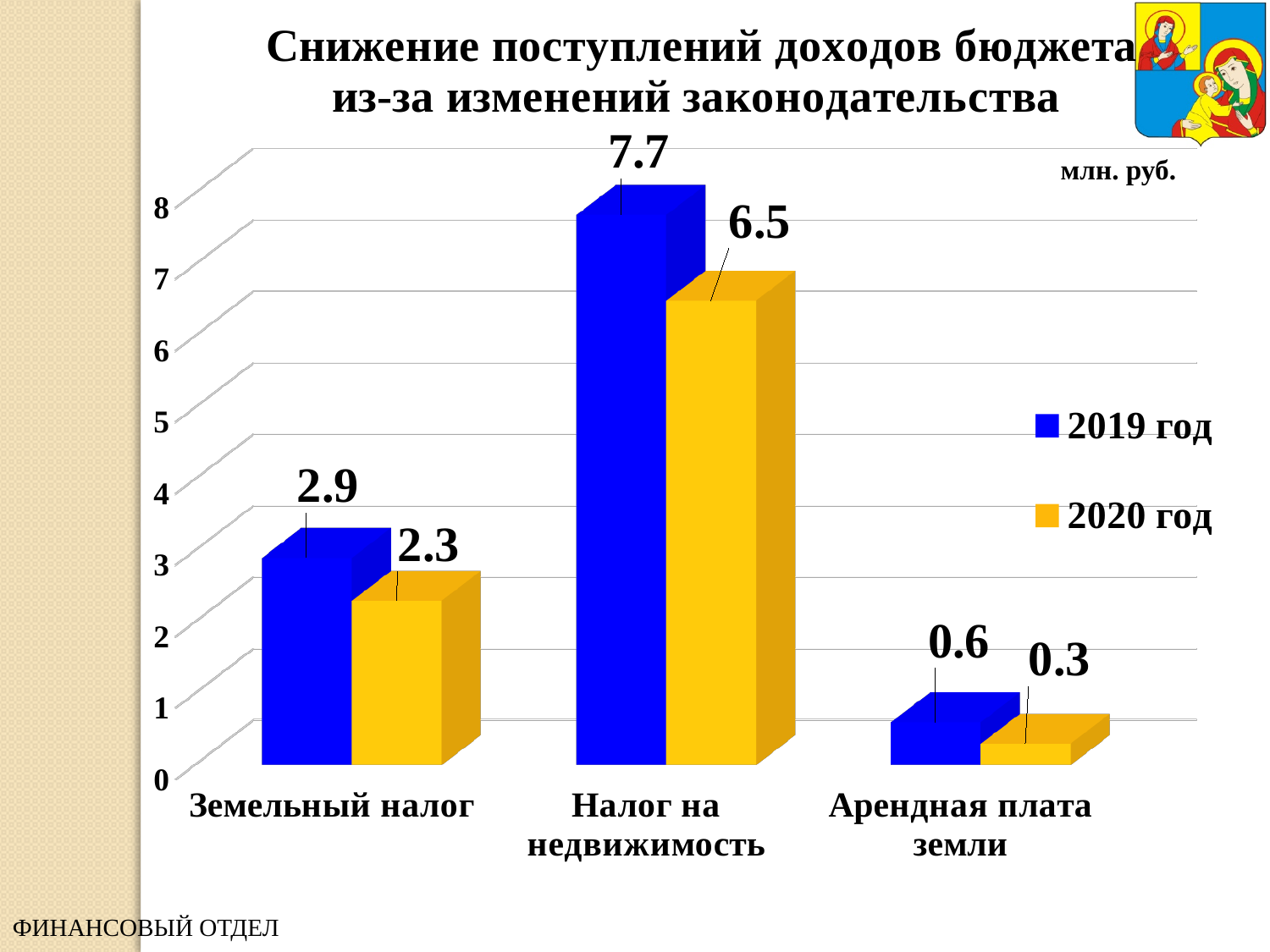
Which is larger: the 2019 год value for Земельный налог or the 2020 год value for Земельный налог? 2019 год How many series does the legend list? 2 What is the value for Арендная плата земли in the 2019 год series? 0.6 What kind of chart is shown on the slide? bar chart What is the difference between the 2019 год and 2020 год values for Налог на недвижимость? 1.2 What unit is indicated for the values on the chart? млн. руб. What is the value for Земельный налог in the 2019 год series? 2.9 Which category has the highest value in the 2019 год series? Налог на недвижимость How many categories are shown on the x axis? 3 Which category has the lowest value in the 2020 год series? Арендная плата земли What is the value for Налог на недвижимость in the 2020 год series? 6.5 What is the difference between the 2019 год and 2020 год values for Земельный налог? 0.6